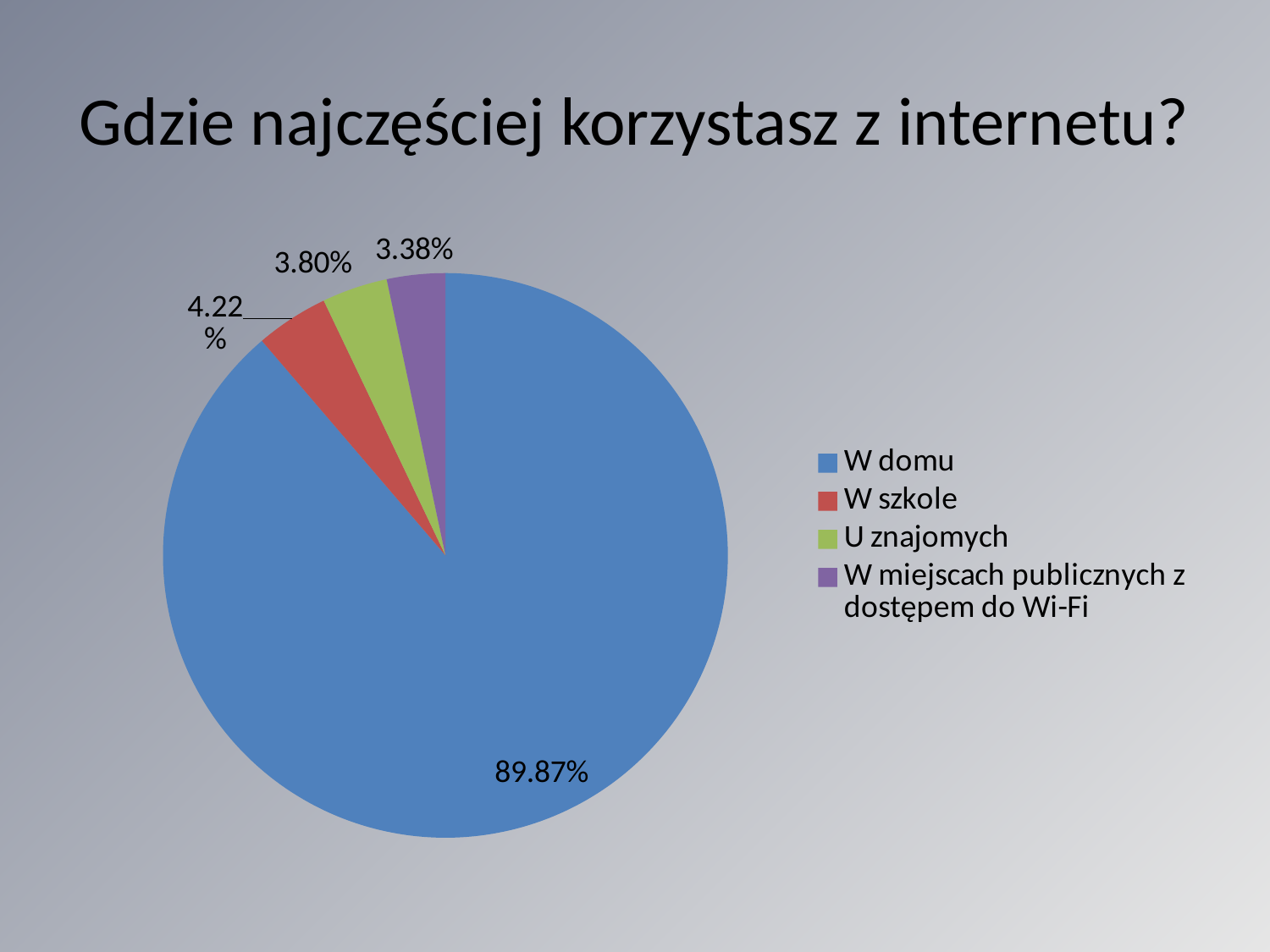
What is the difference between the shares for "W szkole" and "U znajomych"? 0.42% Which is larger, the share for "W szkole" or the share for "W miejscach publicznych z dostępem do Wi-Fi"? W szkole Which category has the smallest share of the pie? W miejscach publicznych z dostępem do Wi-Fi What type of chart is shown on the slide? pie chart Which category has the largest share of the pie? W domu What percentage is shown for "U znajomych"? 3.80% What is the title of the chart? Gdzie najczęściej korzystasz z internetu? What colour is the slice for "U znajomych"? green What percentage is shown for "W miejscach publicznych z dostępem do Wi-Fi"? 3.38% How many categories does the legend list? 4 What percentage is shown for "W domu"? 89.87% What percentage is shown for "W szkole"? 4.22%